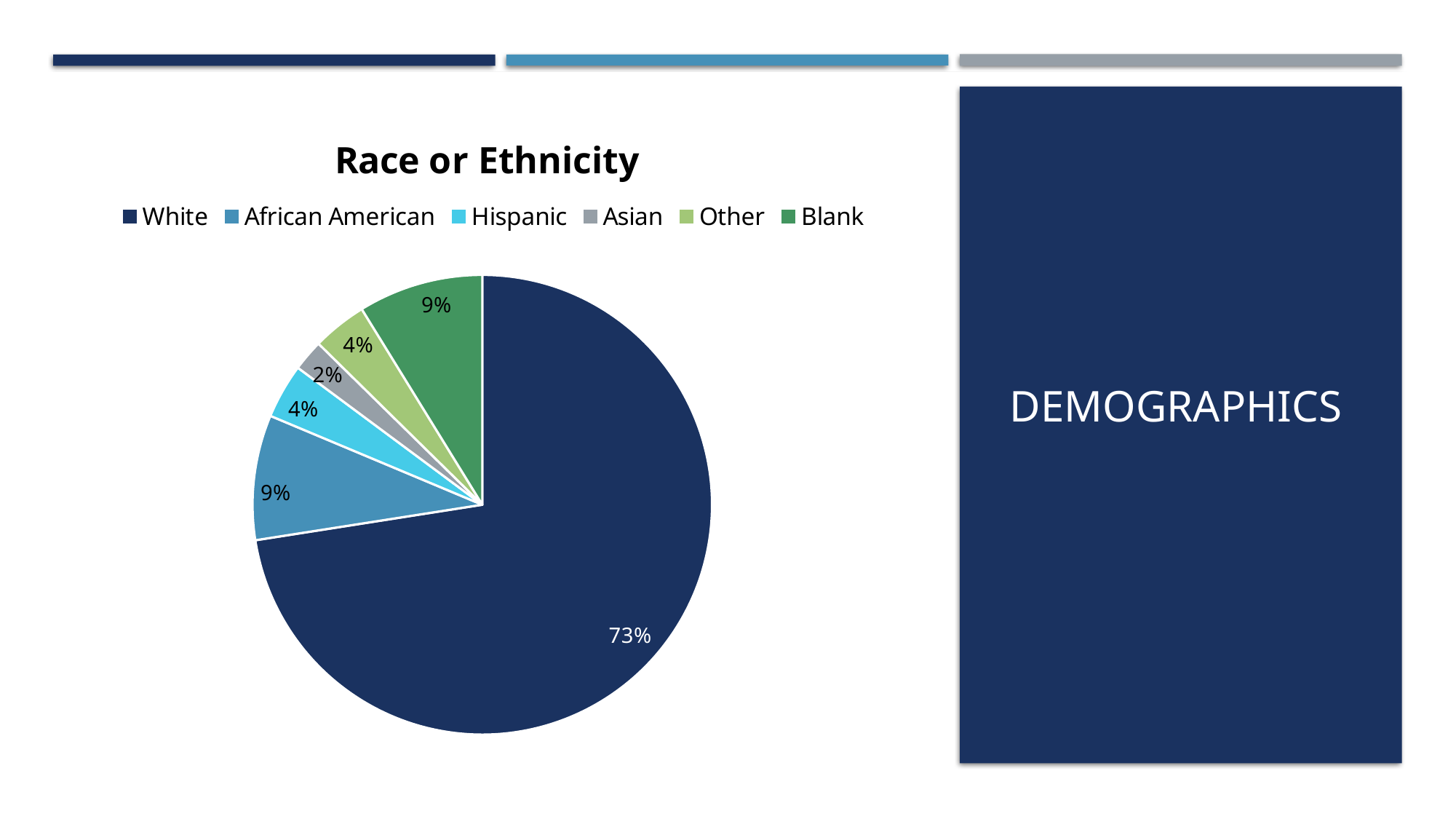
What is the difference in percentage points between the White slice and the African American slice? 64 What percentage of the pie is the White slice? 73% What percentage is shown for Blank? 9% Which is larger, the Other slice or the Asian slice? Other What percentage is shown for Asian? 2% What percentage is shown for African American? 9% What type of chart is shown on the slide? pie chart What percentage is shown for Hispanic? 4% Which category has the largest slice of the pie? White How many categories does the legend list? 6 Which category has the smallest slice of the pie? Asian What is the title of the chart? Race or Ethnicity